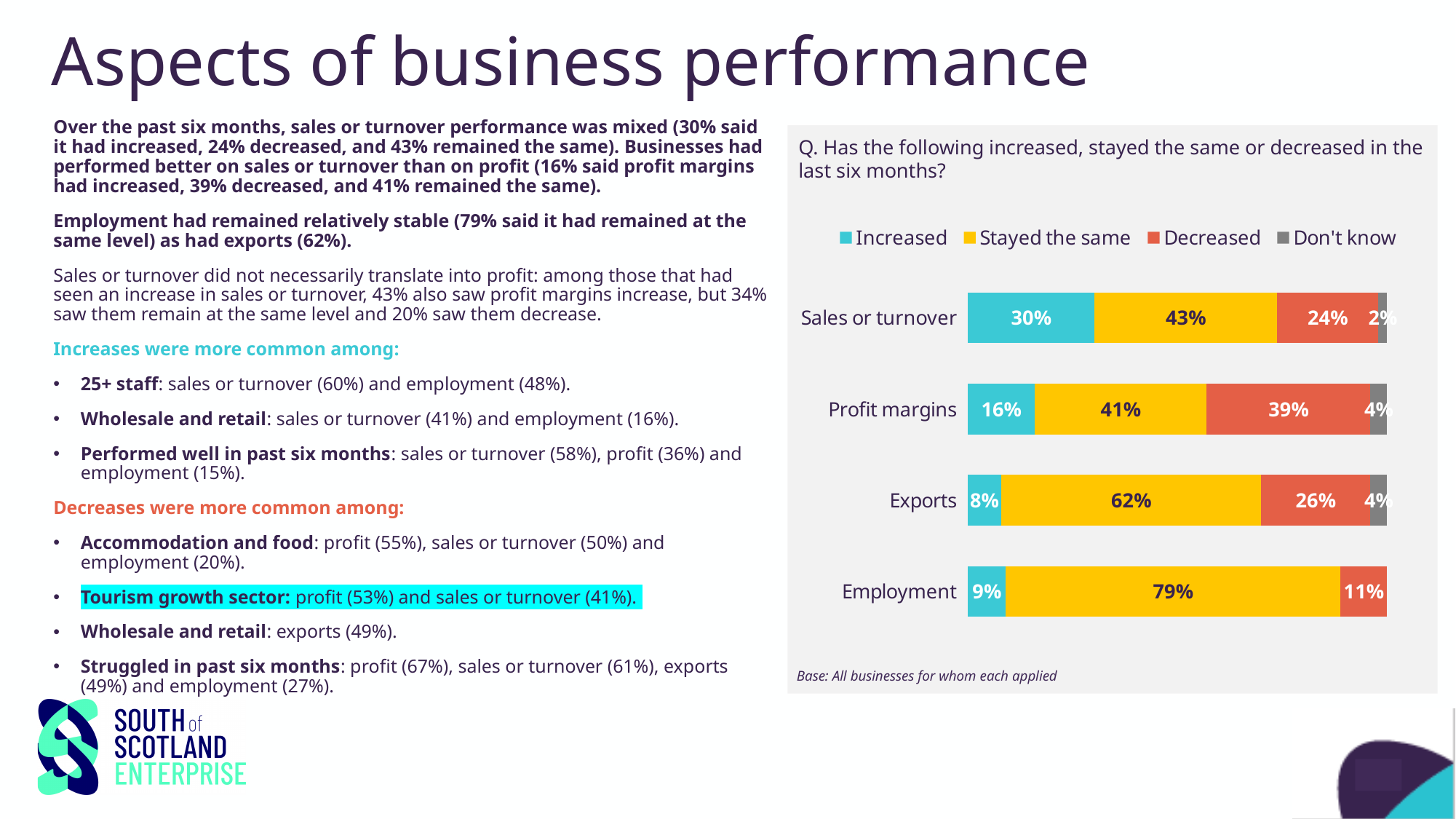
What is the difference between the 'Decreased' percentage for profit margins and for sales or turnover? 15% What percentage of businesses said exports had stayed the same? 62% Which aspect has the lowest 'Increased' percentage? Exports What percentage of businesses said profit margins had decreased? 39% What percentage of businesses said employment had decreased? 11% How many aspects of business performance are shown in the chart? 4 Which aspect has the highest 'Stayed the same' percentage? Employment Which colour represents 'Decreased' in the chart? Red How many series does the chart legend list? 4 Is the 'Increased' percentage larger for sales or turnover or for profit margins? Sales or turnover What percentage of businesses said sales or turnover had increased in the last six months? 30% What type of chart is used to show the survey responses? Stacked bar chart